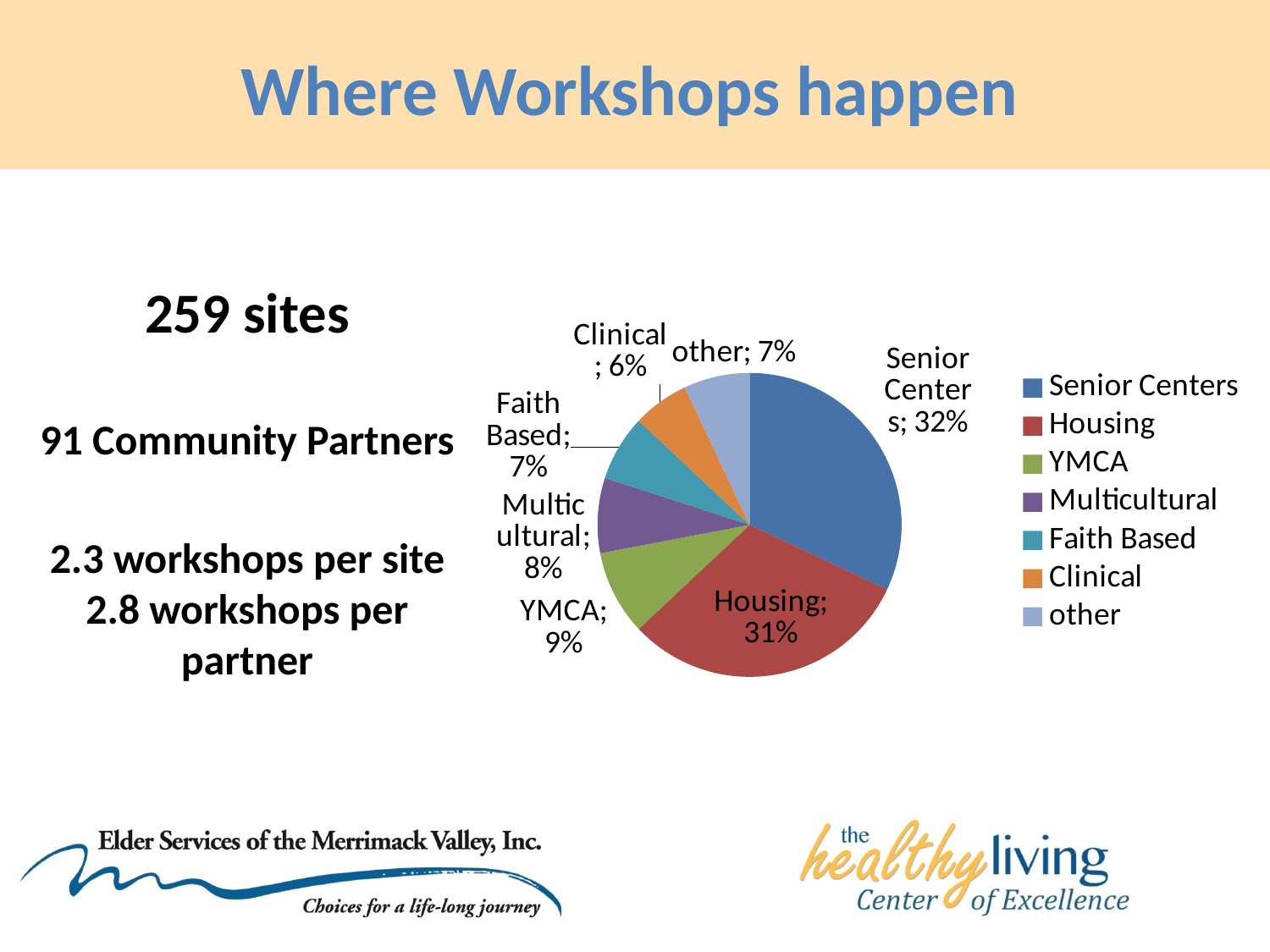
What share of the pie does Clinical have? 6% What kind of chart is shown on the slide? pie chart How many entries does the legend list? 7 What share of the pie does Multicultural have? 8% What share of the pie does Senior Centers have? 32% What share of the pie does YMCA have? 9% Which category has the smallest share of the pie? Clinical Which category has the largest share of the pie? Senior Centers What share of the pie does Housing have? 31% How many categories does the pie chart have? 7 Which has a larger share, YMCA or Multicultural? YMCA What is the difference in percentage points between Senior Centers and Housing? 1